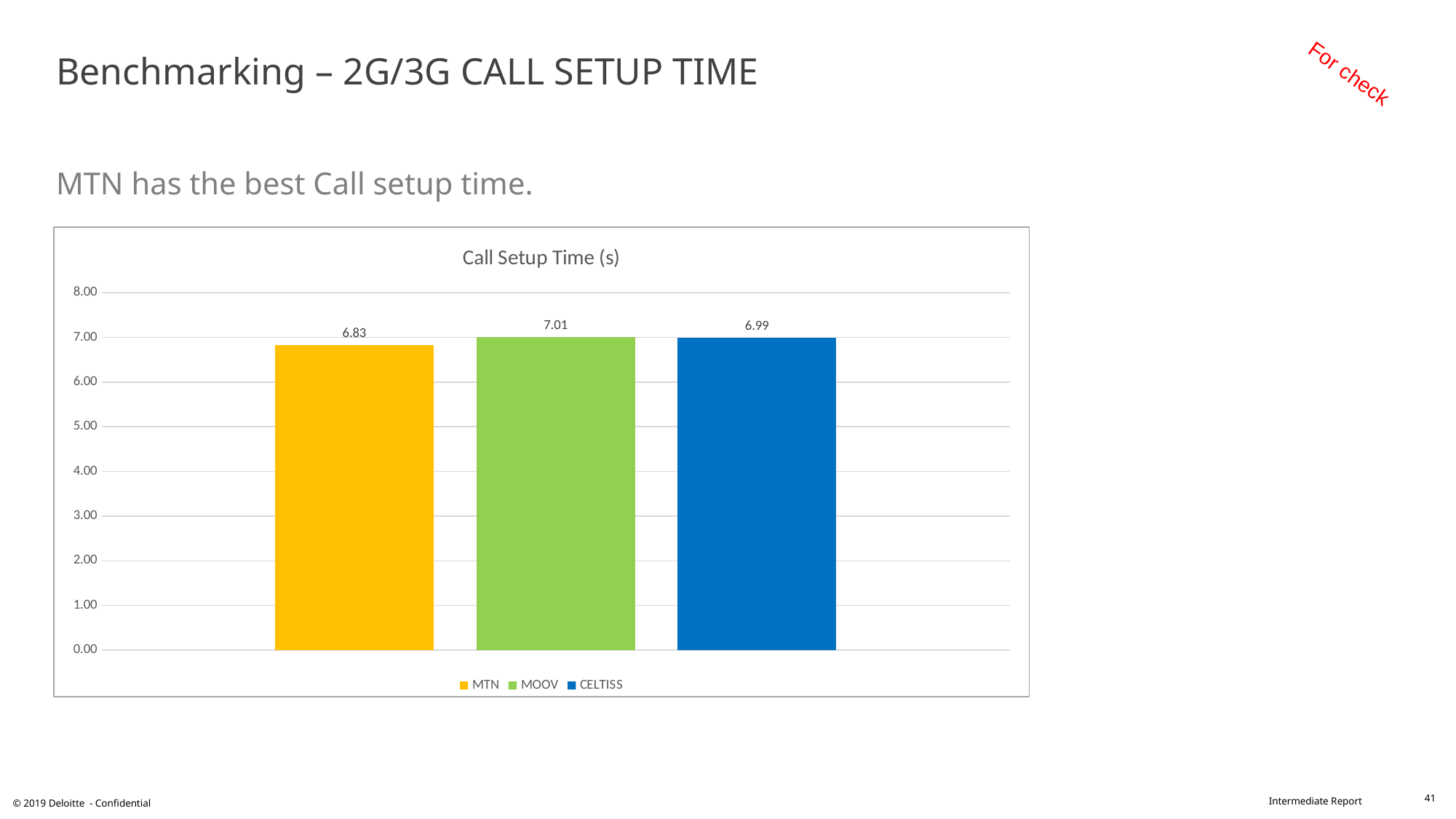
How many operators are shown in the chart? 3 What is the call setup time for MOOV? 7.01 Which operator has the highest call setup time? MOOV What is the call setup time for MTN? 6.83 How many entries does the legend list? 3 What is the title of the chart? Call Setup Time (s) Which operator has the lowest call setup time? MTN What is the difference between the call setup times of MOOV and MTN? 0.18 What type of chart is shown on the slide? bar chart Which has a larger call setup time, MTN or CELTISS? CELTISS What is the call setup time for CELTISS? 6.99 Is the call setup time for MTN greater or less than 7.00? less